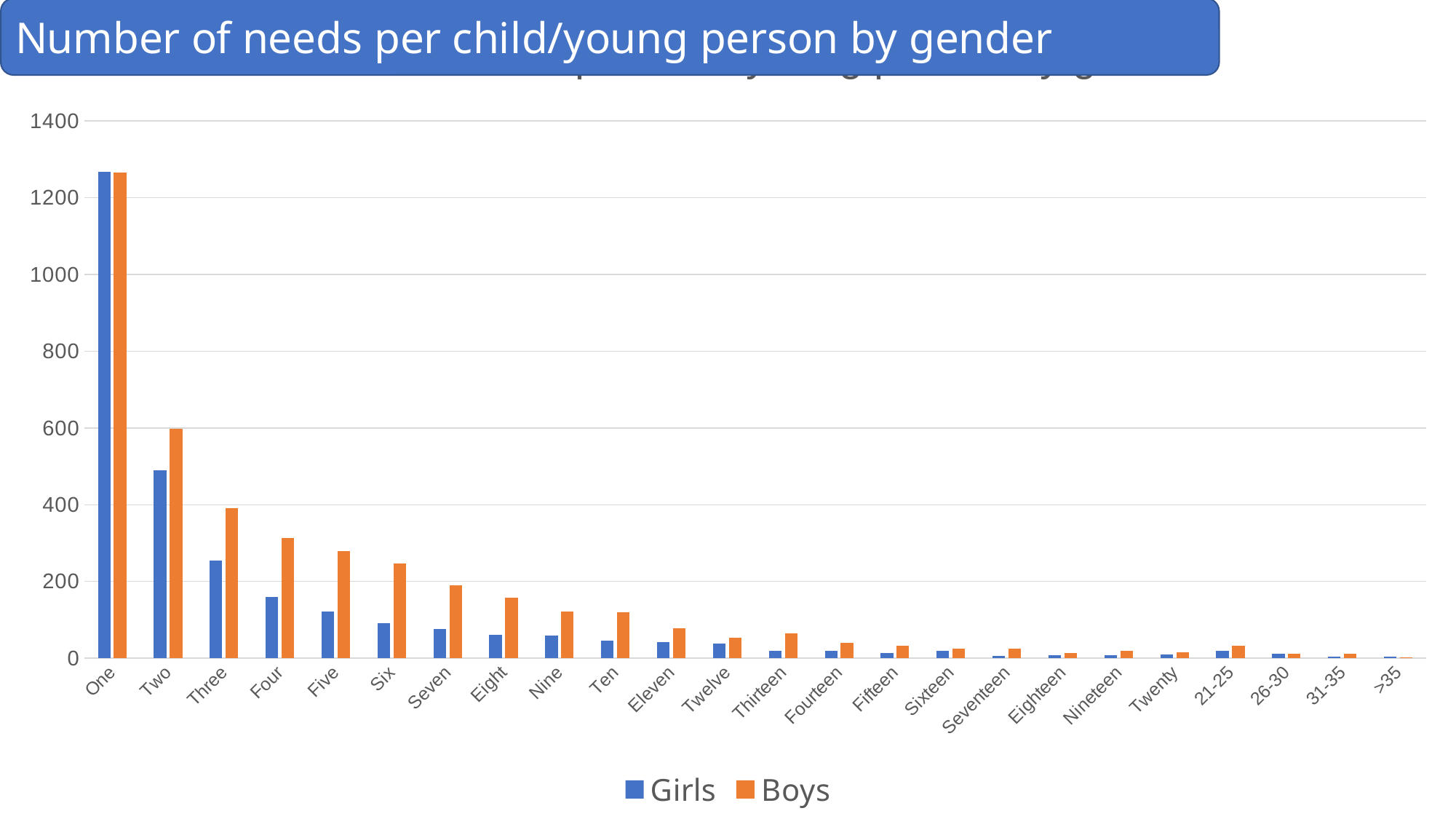
Is the value for Girls in the Four category greater or less than 200? less Which category has the highest value for Girls? One How many series does the legend list? 2 What are the two series named in the legend? Girls and Boys Which category has the highest value for Boys? One In the Three category, which is larger, Girls or Boys? Boys What kind of chart is shown on the slide? bar chart Do the values generally rise or fall moving from One to >35 along the x axis? fall Is the value for Boys in the Two category greater or less than 800? less How many categories are shown along the x axis? 24 Is the value for Girls in the Two category greater or less than 400? greater